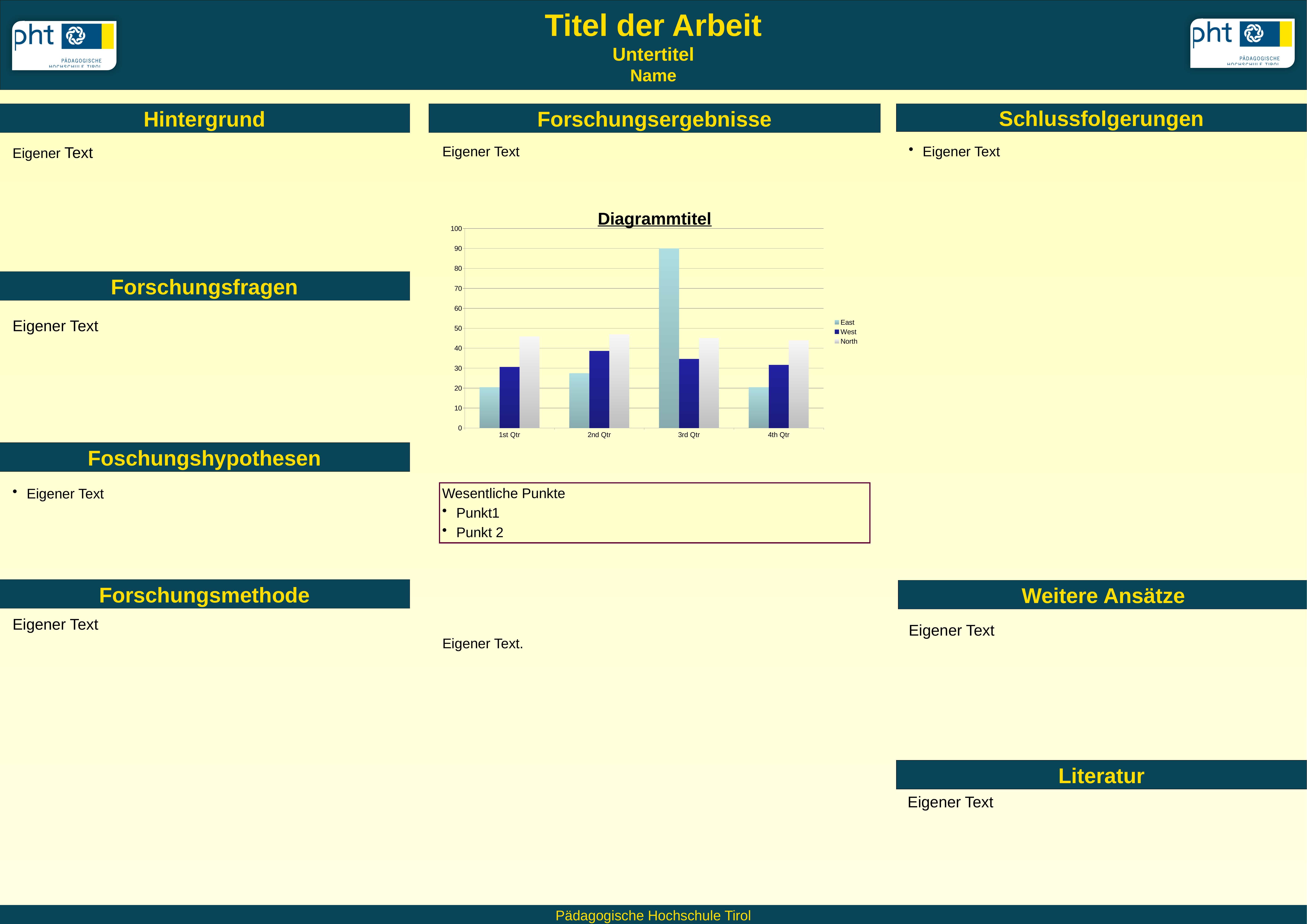
Which series are listed in the chart's legend? East, West, North What kind of chart is shown under the title "Diagrammtitel"? bar chart Is the value for East in 1st Qtr greater or less than 30? less What is the title of the chart? Diagrammtitel In 1st Qtr, which series has the larger value, East or North? North Is the value for North in 2nd Qtr greater or less than 40? greater How many categories are shown on the x axis of the chart? 4 How many series does the chart's legend list? 3 Is the value for East in 3rd Qtr greater or less than 80? greater In which quarter is the East series highest? 3rd Qtr In 3rd Qtr, which series has the larger value, East or West? East